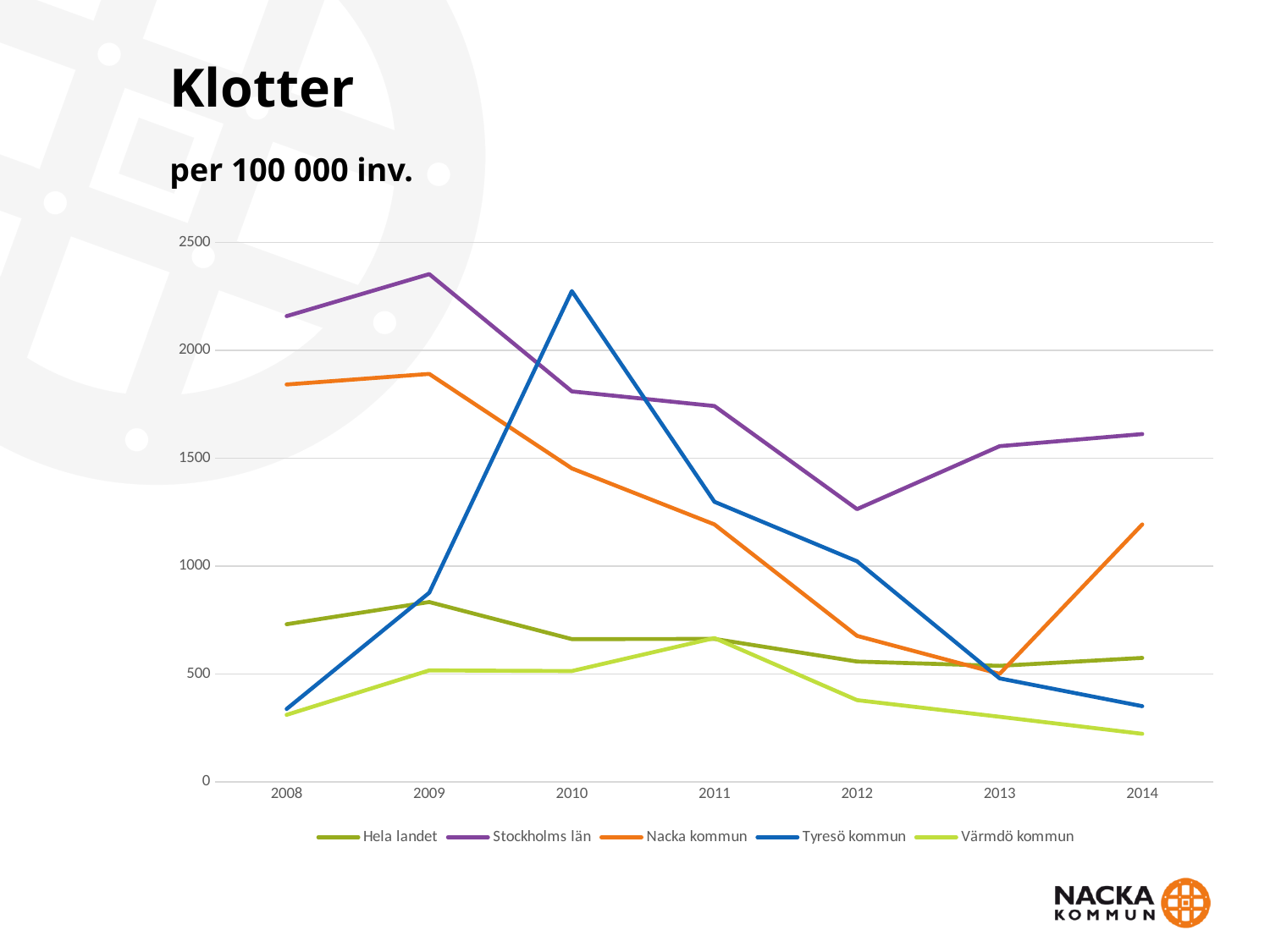
Is the value for Nacka kommun in 2013 greater or less than 1000? less In which year does Stockholms län have its lowest value? 2012 Which series has the lowest value in 2014? Värmdö kommun Is the value for Stockholms län in 2009 greater or less than 2000? greater Do the values for Värmdö kommun rise or fall from 2011 to 2014? fall What kind of chart is shown on the slide? line chart Is the value for Tyresö kommun in 2010 greater or less than 2000? greater Which is larger in 2014, the value for Stockholms län or the value for Nacka kommun? Stockholms län In which year does Tyresö kommun reach its highest value? 2010 Which series has the highest value in 2009? Stockholms län How many years are shown on the x axis? 7 How many series does the legend list? 5